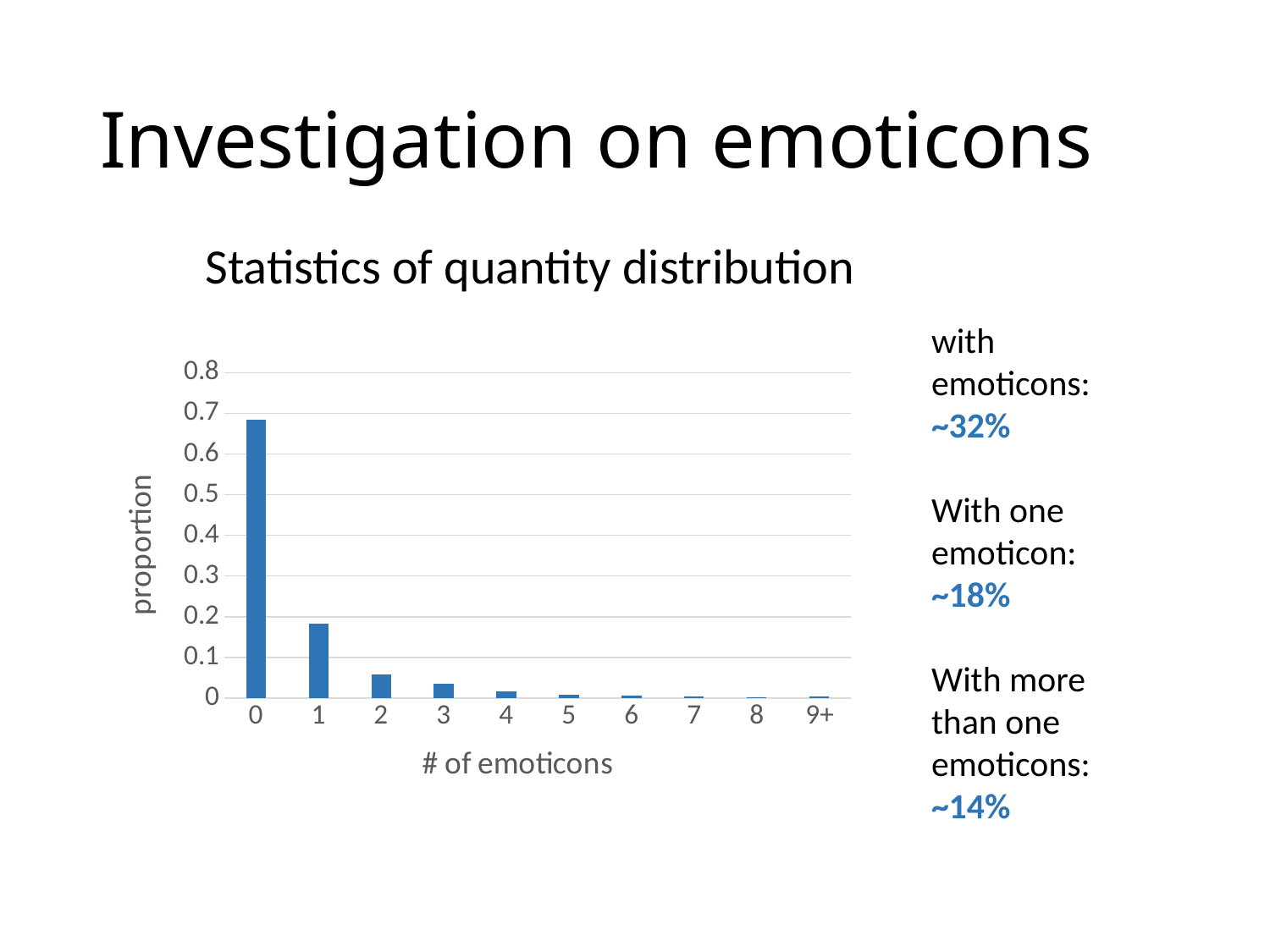
Which has a larger proportion, 1 emoticon or 2 emoticons? 1 What is the label of the x axis of the chart? # of emoticons Is the proportion for 0 emoticons greater or less than 0.7? less What is the title of the chart? Statistics of quantity distribution Is the proportion for 1 emoticon greater or less than 0.1? greater Is the proportion for 0 emoticons greater or less than 0.6? greater How many categories are shown on the x axis of the chart? 10 What kind of chart is shown on the slide? bar chart Do the proportions rise or fall as the number of emoticons increases along the x axis? fall Which number of emoticons has the highest proportion? 0